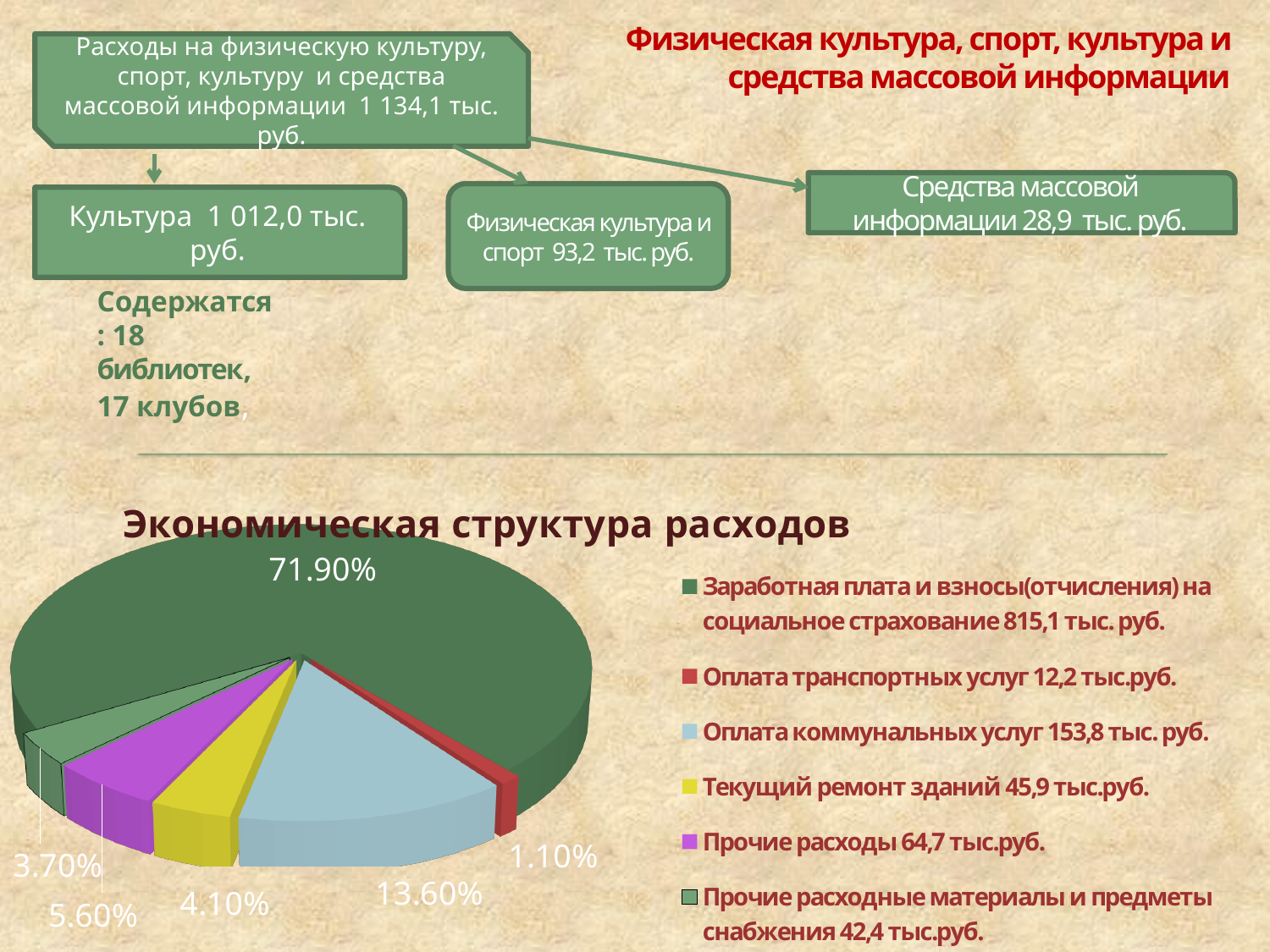
Which category has the largest slice of the pie? Заработная плата и взносы(отчисления) на социальное страхование Which slice is larger: "Текущий ремонт зданий" or "Прочие расходы"? Прочие расходы What share of the pie does "Оплата транспортных услуг" take? 1.10% What share of the pie does "Прочие расходы" take? 5.60% What share of the pie does "Заработная плата и взносы(отчисления) на социальное страхование" take? 71.90% Which category has the smallest slice of the pie? Оплата транспортных услуг What kind of chart is shown under the title "Экономическая структура расходов"? pie chart What is the difference in percentage points between the "Оплата коммунальных услуг" slice and the "Прочие расходы" slice? 8.00% How many slices does the pie chart have? 6